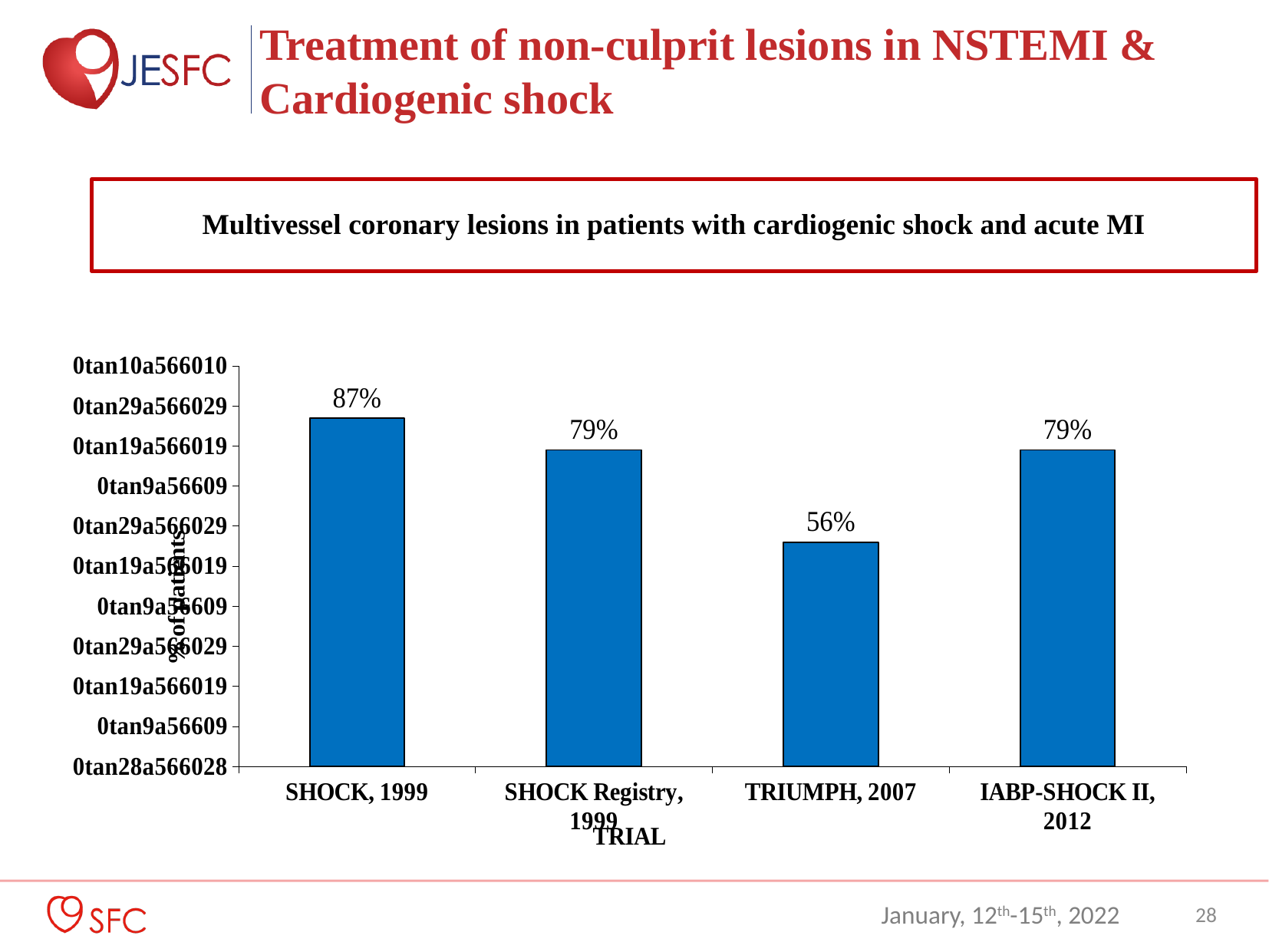
Which trial has the lowest value? TRIUMPH, 2007 What kind of chart is shown on the slide? Bar chart What is the value for SHOCK Registry, 1999? 79% What is the difference between the values for SHOCK, 1999 and SHOCK Registry, 1999? 8% What is the value for IABP-SHOCK II, 2012? 79% What is the title of the x axis of the chart? TRIAL What is the value for SHOCK, 1999? 87% What is the difference between the values for SHOCK, 1999 and TRIUMPH, 2007? 31% Which is larger, the value for SHOCK Registry, 1999 or the value for TRIUMPH, 2007? SHOCK Registry, 1999 Which trial has the highest value? SHOCK, 1999 How many trials are shown on the x axis of the chart? 4 What is the value for TRIUMPH, 2007? 56%